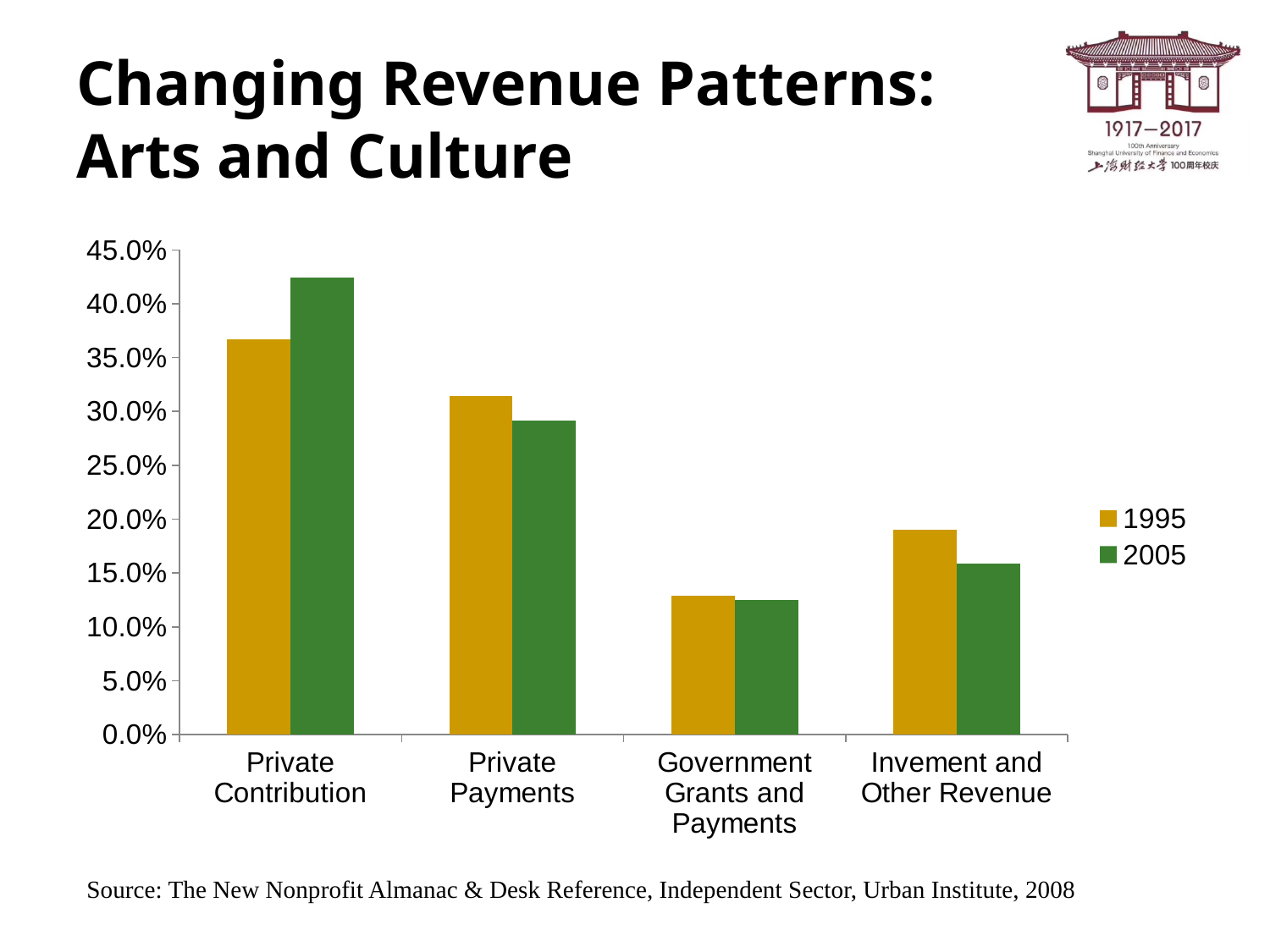
For Private Contribution, which year has the larger value, 1995 or 2005? 2005 Which category has the highest value for 2005? Private Contribution For Invement and Other Revenue, which year has the larger value, 1995 or 2005? 1995 Is the value for Private Contribution in 2005 greater or less than 40.0%? greater How many categories are shown on the x axis? 4 Which colour represents the 1995 series in the legend? gold What kind of chart is shown on the slide? bar chart Which category has the lowest value for 1995? Government Grants and Payments Is the value for Private Payments in 2005 greater or less than 30.0%? less How many series does the legend list? 2 Is the value for Government Grants and Payments in 1995 greater or less than 15.0%? less